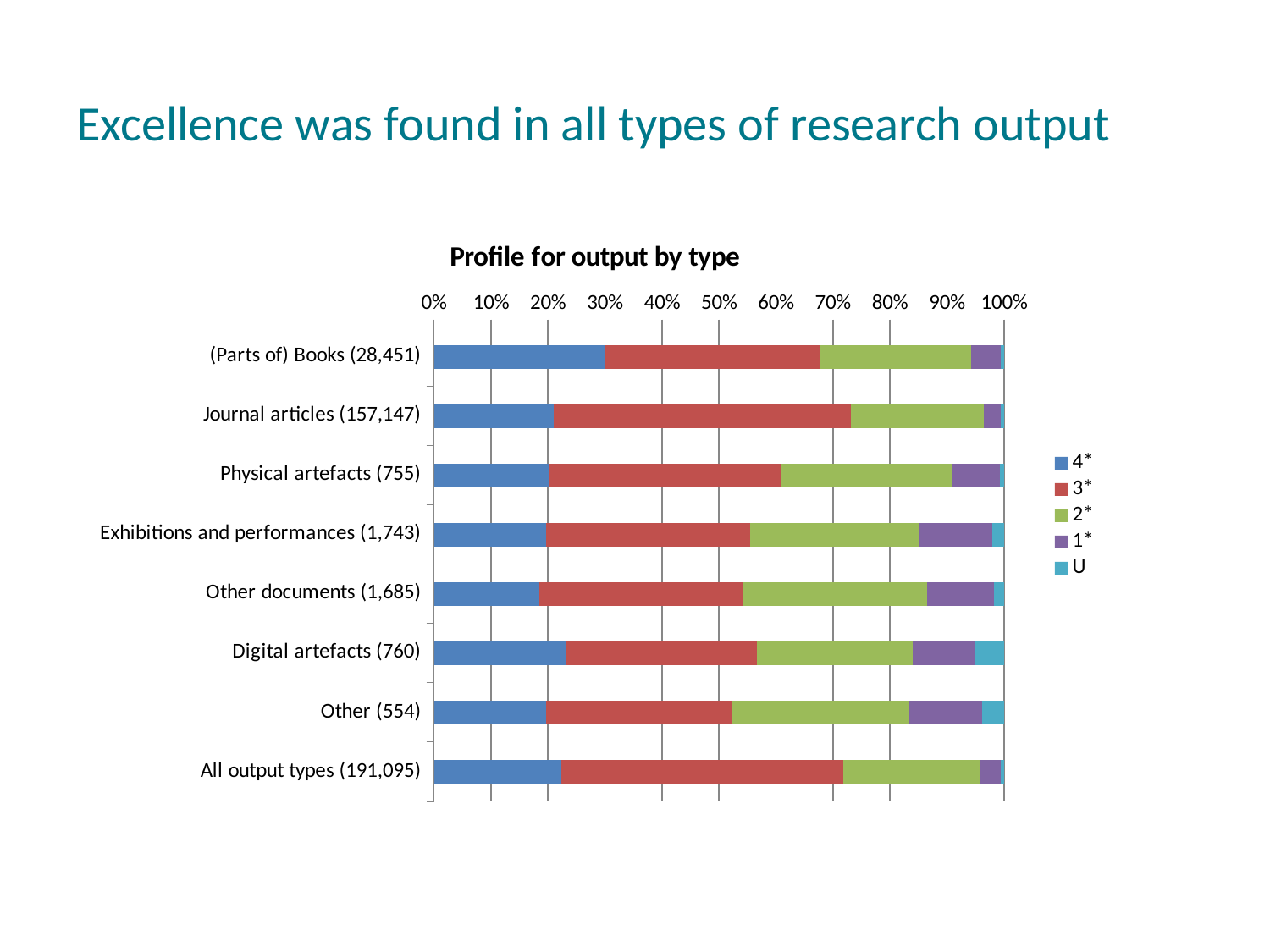
Is the 4* share for (Parts of) Books (28,451) greater or less than 20%? greater Which series are listed in the chart legend? 4*, 3*, 2*, 1*, U Which has the larger 3* share: Journal articles (157,147) or Other (554)? Journal articles (157,147) How many output type categories are plotted on the chart? 8 What kind of chart is shown on the slide? Stacked bar chart Which has the larger 2* share: Other (554) or Journal articles (157,147)? Other (554) Is the 4* share for Journal articles (157,147) greater or less than 30%? less Is the 4* share for Other (554) greater or less than 30%? less Which output type has the largest 4* share? (Parts of) Books (28,451) What is the title of the chart? Profile for output by type Which has the larger 4* share: (Parts of) Books (28,451) or Journal articles (157,147)? (Parts of) Books (28,451) How many series does the chart legend list? 5